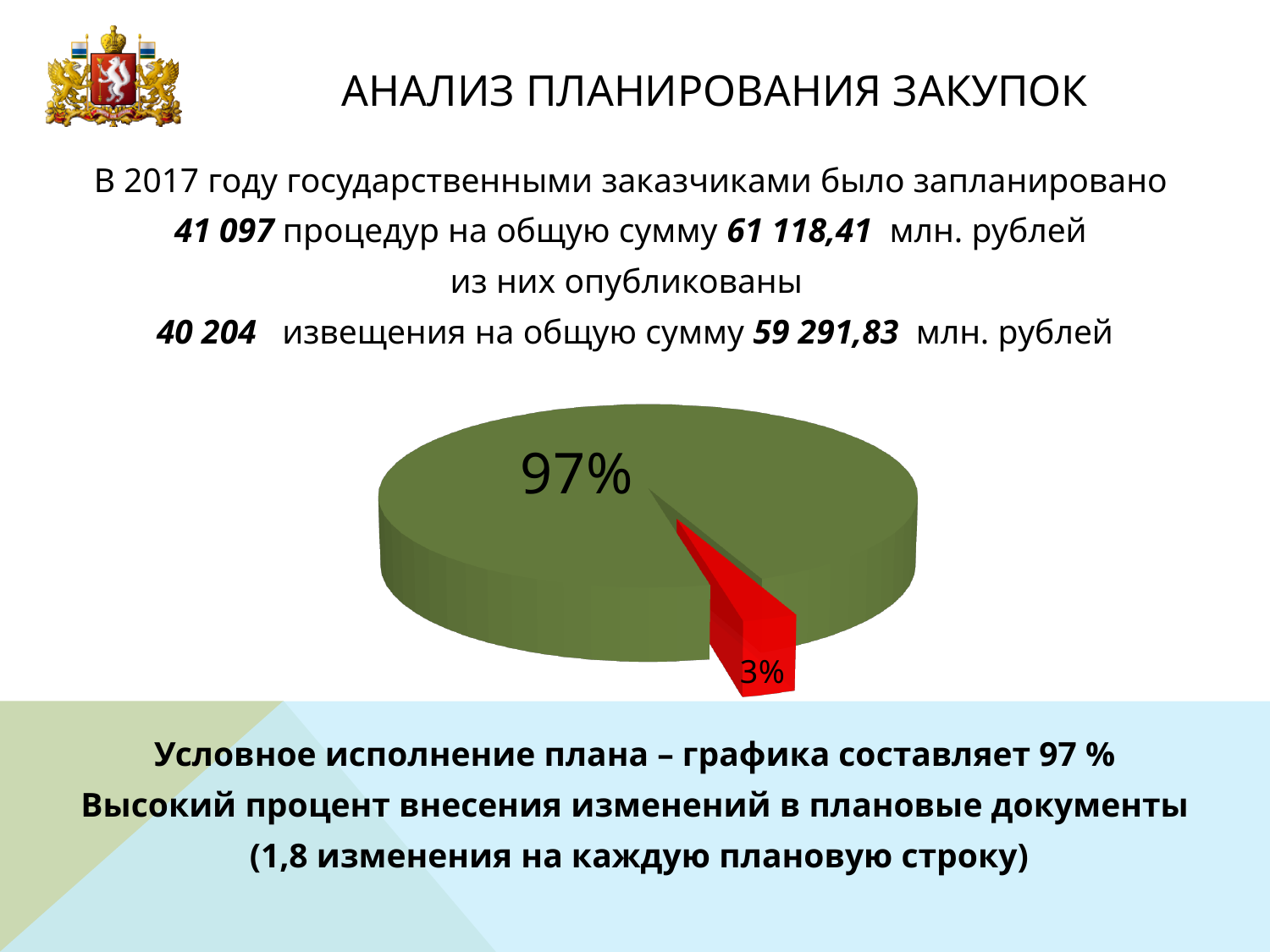
Is the value of the red slice greater or less than 10%? less Which slice of the pie chart is the smallest? the red slice (3%) What colour is the slice labelled 3%? red Is the value of the green slice greater or less than 50%? greater What share of the pie does the green slice represent? 97% Which is larger, the green slice or the red slice? the green slice Which slice of the pie chart is the largest? the green slice (97%) What kind of chart is shown on the slide? pie chart Does the pie chart have a legend? No How many slices does the pie chart have? 2 What share of the pie does the red slice represent? 3% What is the difference in percentage points between the green slice and the red slice? 94